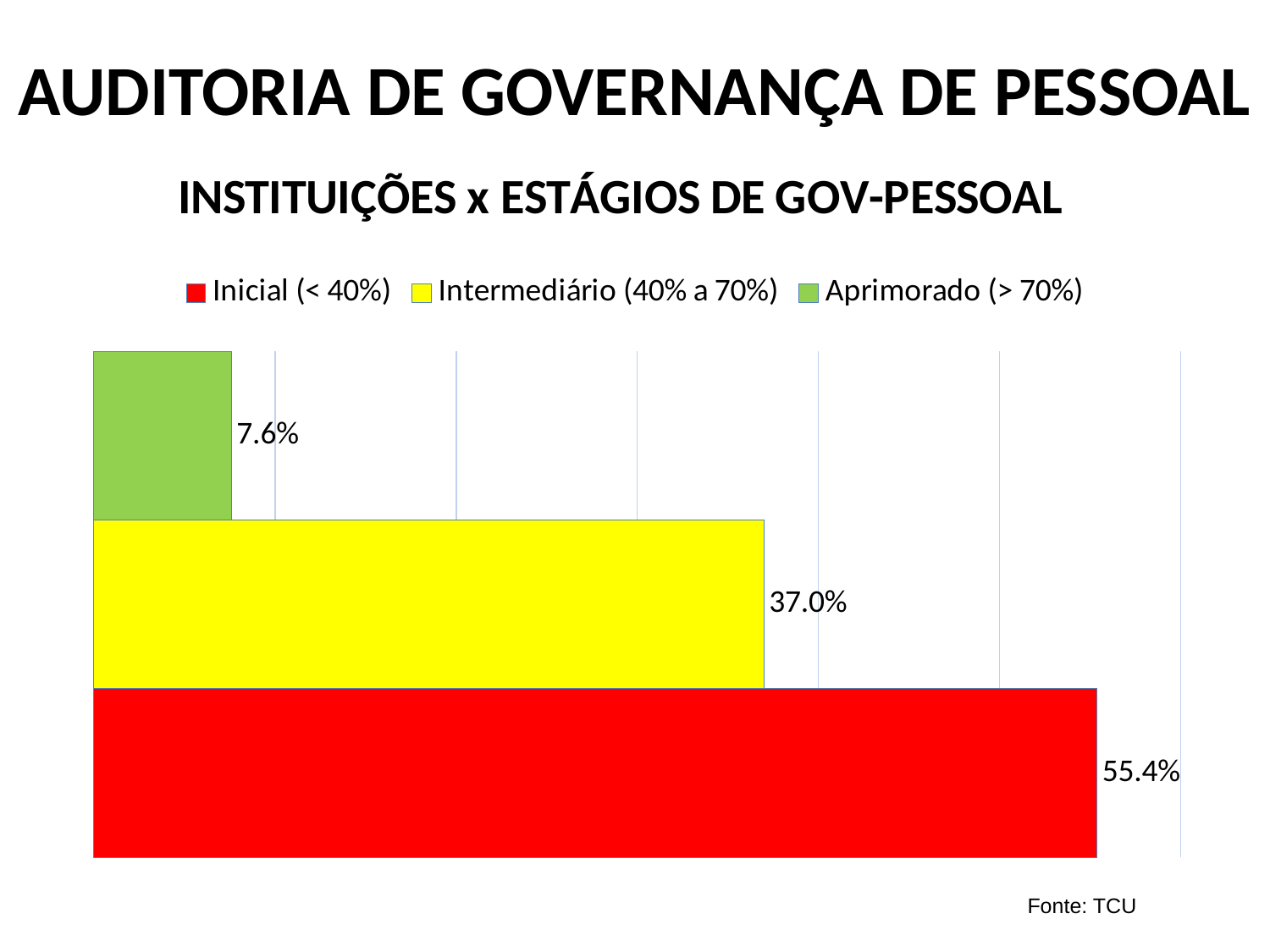
Which stage has the highest value? Inicial (< 40%) How many series does the legend list? 3 What colour is the bar for Aprimorado (> 70%)? Green What is the difference between the values for Inicial (< 40%) and Intermediário (40% a 70%)? 18.4% Which is larger, the value for Intermediário (40% a 70%) or the value for Aprimorado (> 70%)? Intermediário (40% a 70%) What kind of chart is shown on the slide? Bar chart What is the value for Inicial (< 40%)? 55.4% What is the title of the chart? INSTITUIÇÕES x ESTÁGIOS DE GOV-PESSOAL Which stage has the lowest value? Aprimorado (> 70%) What is the difference between the values for Intermediário (40% a 70%) and Aprimorado (> 70%)? 29.4% What is the value for Intermediário (40% a 70%)? 37.0% What is the value for Aprimorado (> 70%)? 7.6%